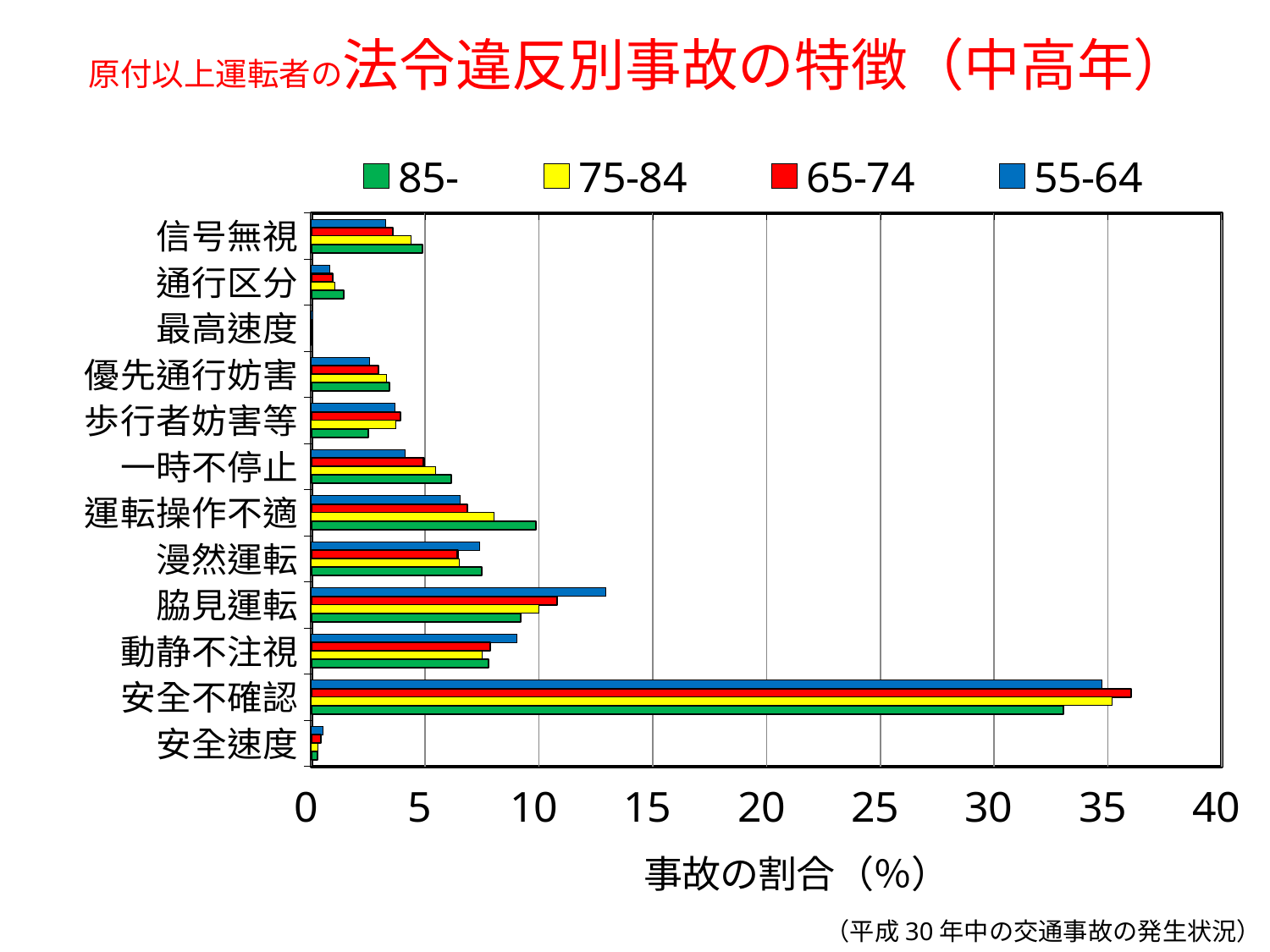
Which category has the highest value for the 55-64 series? 安全不確認 What is the title of the x axis? 事故の割合（%） Is the value for 脇見運転 in the 55-64 series greater or less than 10? greater Is the value for 一時不停止 in the 85- series greater or less than 5? greater Which category has the lowest value for the 55-64 series? 最高速度 Is the value for 安全不確認 in the 65-74 series greater or less than 35? greater For 脇見運転, which series has the larger value: 55-64 or 85-? 55-64 How many violation categories are plotted on the y axis? 12 How many series does the legend list? 4 What kind of chart is shown on the slide? bar chart For 信号無視, which series has the larger value: 85- or 55-64? 85-